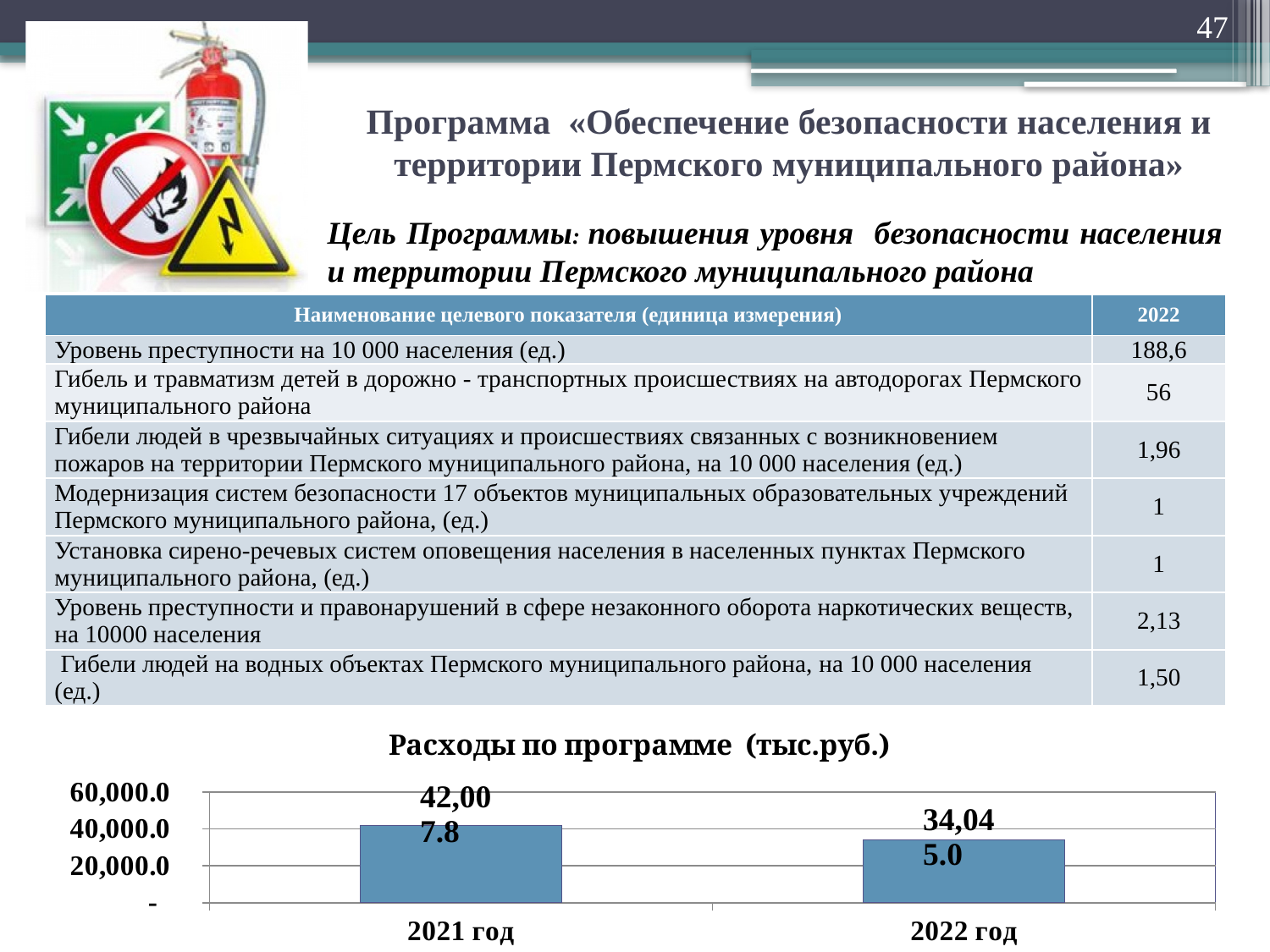
In the chart "Расходы по программе (тыс.руб.)", is the value for 2022 год greater or less than 40,000.0? less What is the title of the chart at the bottom of the slide? Расходы по программе (тыс.руб.) In the chart "Расходы по программе (тыс.руб.)", is the value for 2021 год greater or less than 20,000.0? greater In the chart "Расходы по программе (тыс.руб.)", do the values rise or fall from 2021 год to 2022 год? fall What is the highest tick value shown on the vertical axis of the chart "Расходы по программе (тыс.руб.)"? 60,000.0 In the chart "Расходы по программе (тыс.руб.)", which year has the higher bar? 2021 год How many categories (years) are plotted in the chart "Расходы по программе (тыс.руб.)"? 2 What kind of chart is shown at the bottom of the slide? bar chart In the chart "Расходы по программе (тыс.руб.)", is the bar for 2021 год larger or smaller than the bar for 2022 год? larger In the chart "Расходы по программе (тыс.руб.)", which year has the lower bar? 2022 год In the chart "Расходы по программе (тыс.руб.)", is the value for 2022 год greater or less than 20,000.0? greater